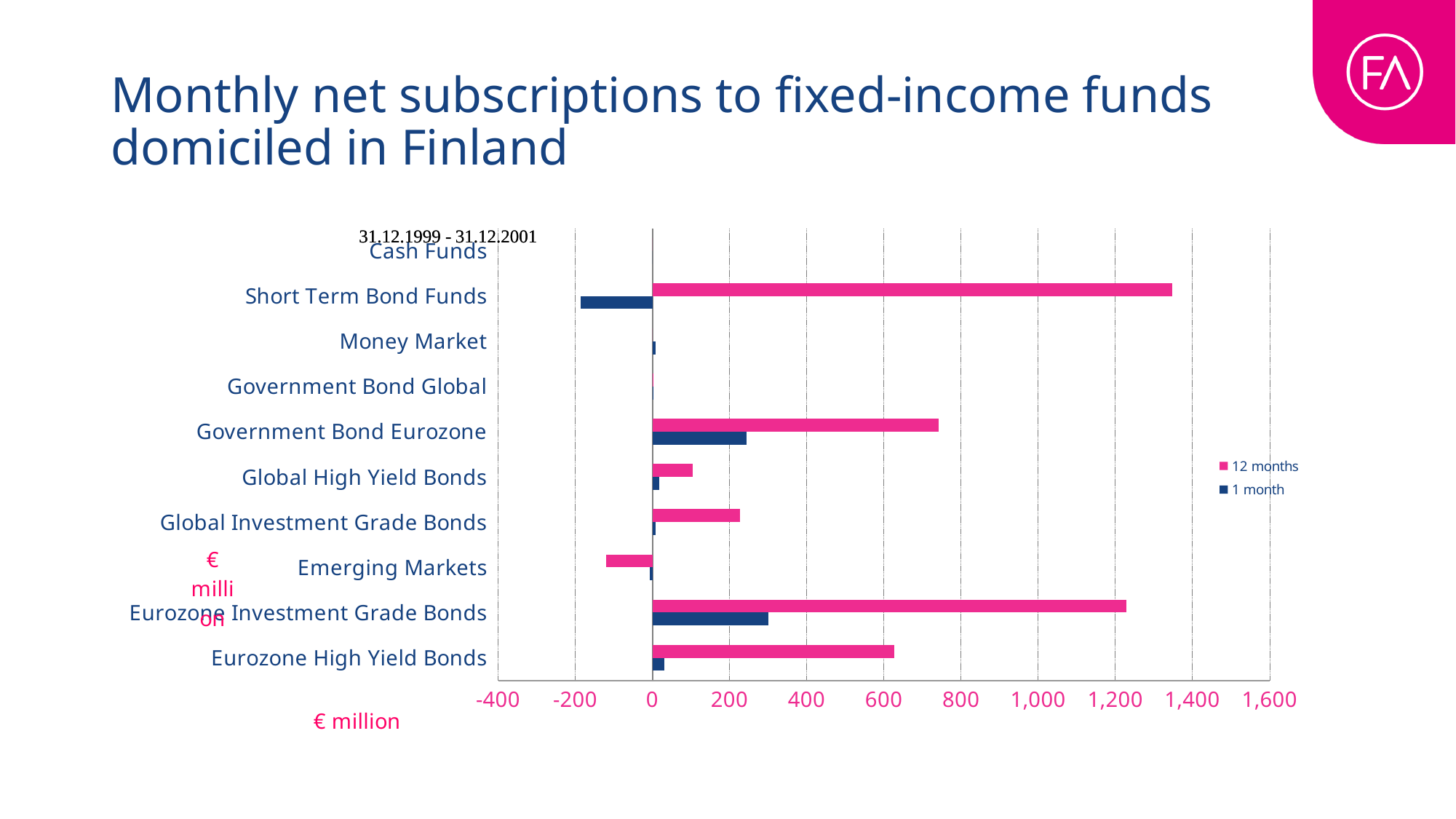
Which category has the highest 1 month value? Eurozone Investment Grade Bonds Is the 12 months value for Short Term Bond Funds greater or less than 1,200? greater How many fund categories are shown on the y axis? 10 What unit is shown on the x axis label? € million What kind of chart is shown on the slide? bar chart Which category has the lowest 1 month value? Short Term Bond Funds Which is larger: the 12 months value for Government Bond Eurozone or for Eurozone High Yield Bonds? Government Bond Eurozone Is the 1 month value for Short Term Bond Funds greater or less than 0? less How many series does the legend list? 2 Is the 12 months value for Government Bond Eurozone greater or less than 600? greater Which category has the highest 12 months value? Short Term Bond Funds Which category has the lowest 12 months value? Emerging Markets